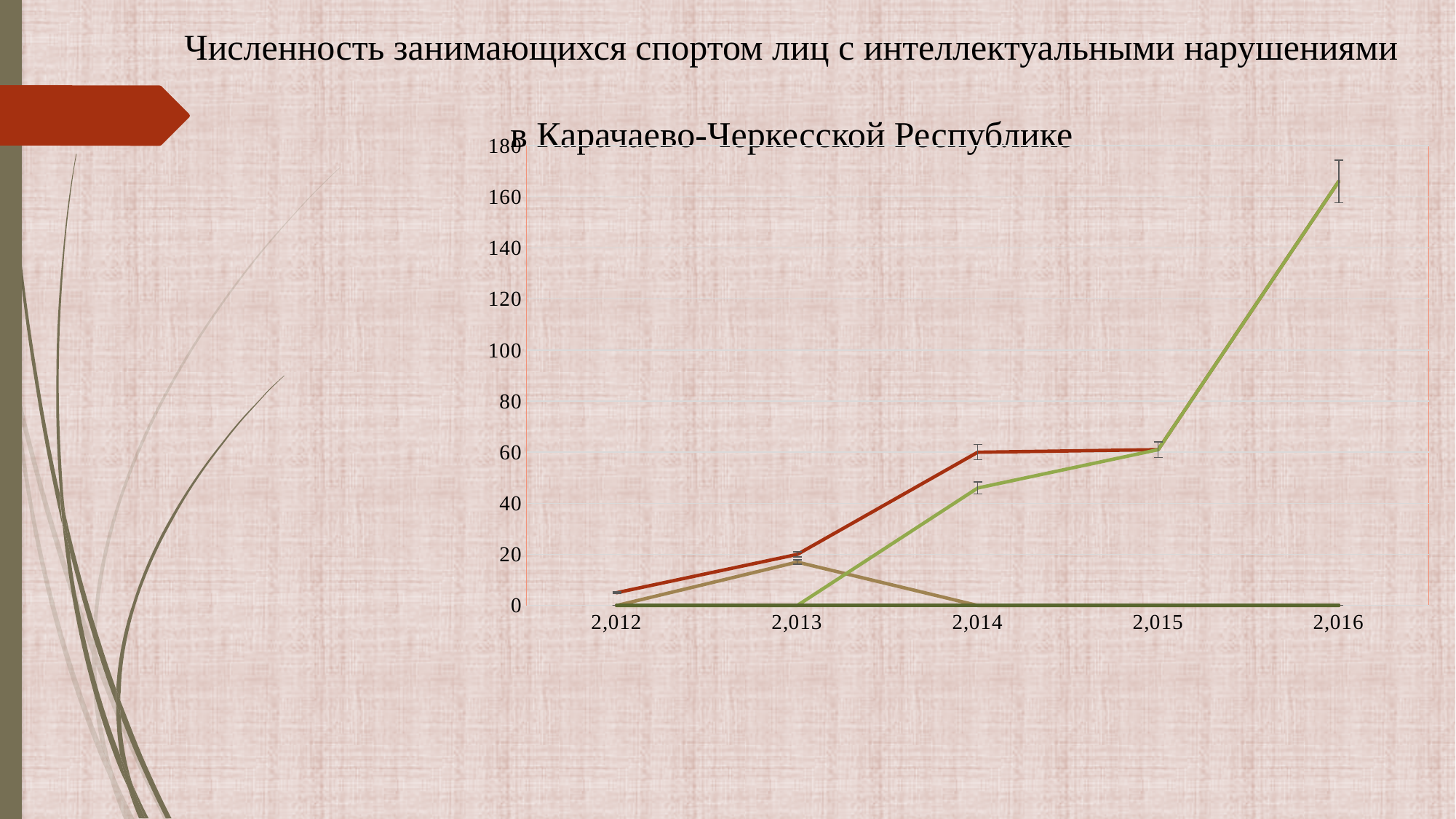
Is the value of the tan line for 2,013 greater or less than 40? less In which year does the light green line reach its highest value? 2,016 How many years are shown along the x axis of the chart? 5 What kind of chart is shown on the slide? line chart What is the first year shown on the x axis of the chart? 2,012 Is the value of the red line for 2,013 greater or less than 40? less What is the last year shown on the x axis of the chart? 2,016 Does the light green line rise or fall between 2,014 and 2,016? rise Is the value of the red line for 2,014 greater or less than 40? greater Which is larger in 2,014: the value of the red line or the value of the light green line? the red line